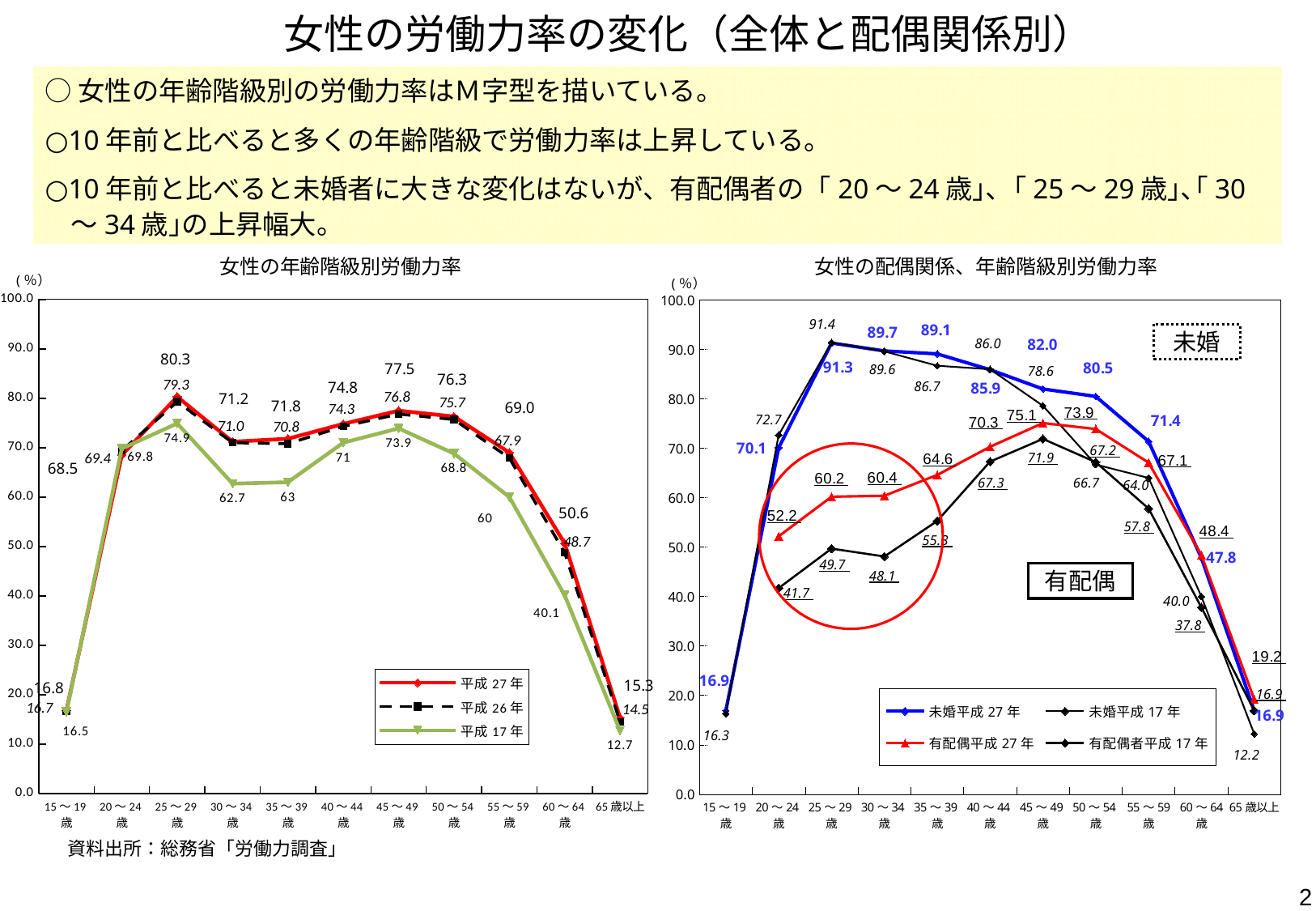
In the left chart (女性の年齢階級別労働力率), what is the value for 平成27年 at 25～29歳? 80.3 In the right chart (女性の配偶関係、年齢階級別労働力率), which age category has the highest value for 未婚平成27年? 25～29歳 What kind of chart is the left chart titled 女性の年齢階級別労働力率? Line chart In the left chart (女性の年齢階級別労働力率), how many series does the legend list? 3 In the right chart (女性の配偶関係、年齢階級別労働力率), what is the value for 有配偶平成27年 at 20～24歳? 52.2 In the left chart (女性の年齢階級別労働力率), what is the difference between 平成27年 and 平成17年 at 30～34歳? 8.5 In the right chart (女性の配偶関係、年齢階級別労働力率), how many series does the legend list? 4 In the left chart (女性の年齢階級別労働力率), which age category has the lowest value for 平成17年? 65歳以上 In the left chart (女性の年齢階級別労働力率), which age category has the highest value for 平成27年? 25～29歳 What data source is cited below the charts? 総務省「労働力調査」 In the left chart (女性の年齢階級別労働力率), how many age categories are shown on the x axis? 11 In the right chart (女性の配偶関係、年齢階級別労働力率), at 25～29歳, which is larger: 有配偶平成27年 or 有配偶者平成17年? 有配偶平成27年